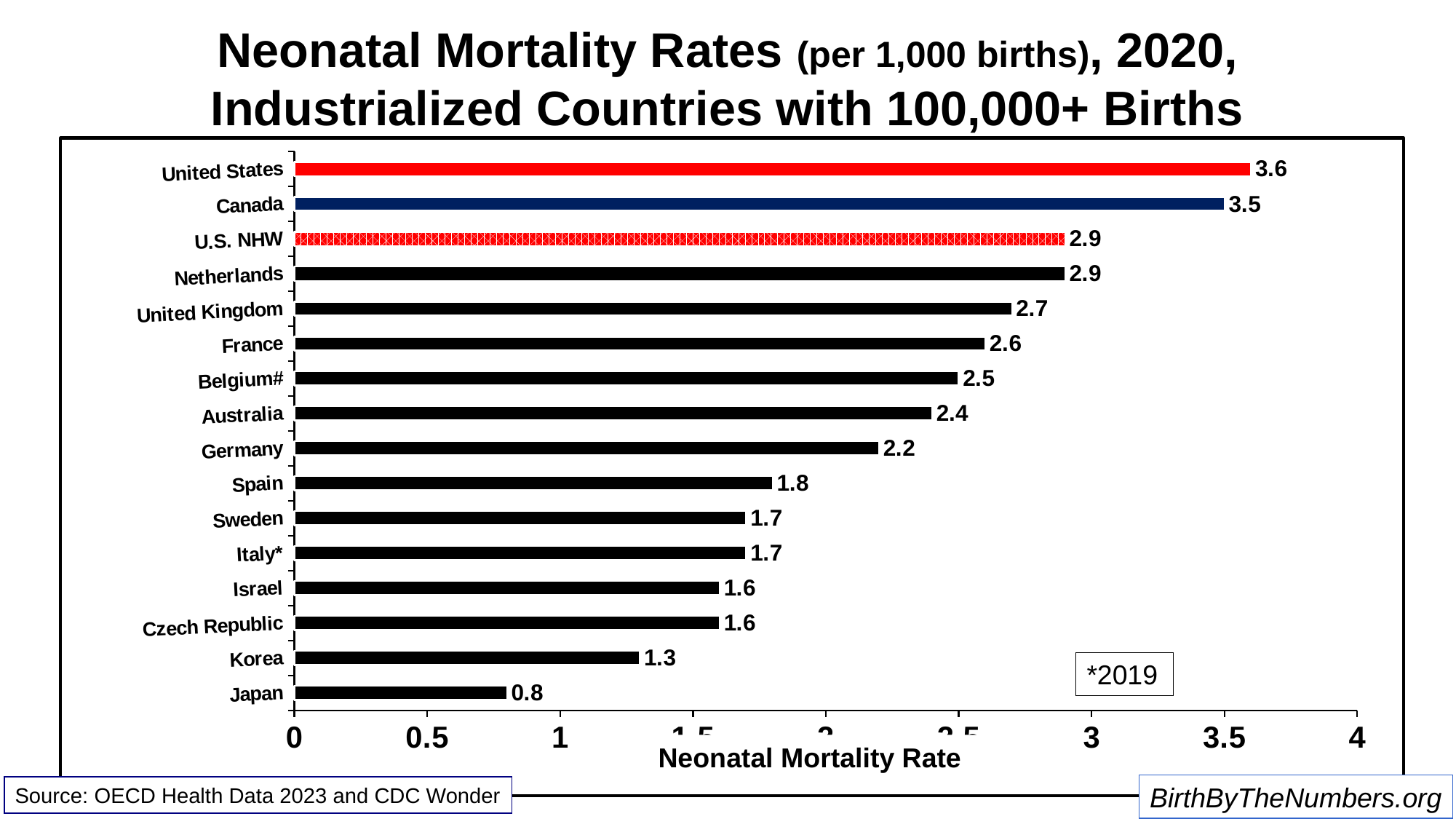
Is the value for Korea greater or less than 1.5? less What is the difference between the neonatal mortality rates of the United States and Japan? 2.8 What is the neonatal mortality rate shown for the United States? 3.6 What kind of chart is shown on the slide? bar chart What is the label on the horizontal axis of the chart? Neonatal Mortality Rate What is the neonatal mortality rate shown for Germany? 2.2 Which country or group has the highest neonatal mortality rate on the chart? United States Which has a higher neonatal mortality rate, France or Australia? France What is the difference between the neonatal mortality rates of Canada and the United Kingdom? 0.8 Which country has the lowest neonatal mortality rate on the chart? Japan What is the neonatal mortality rate shown for Japan? 0.8 How many countries or groups are shown on the chart? 16